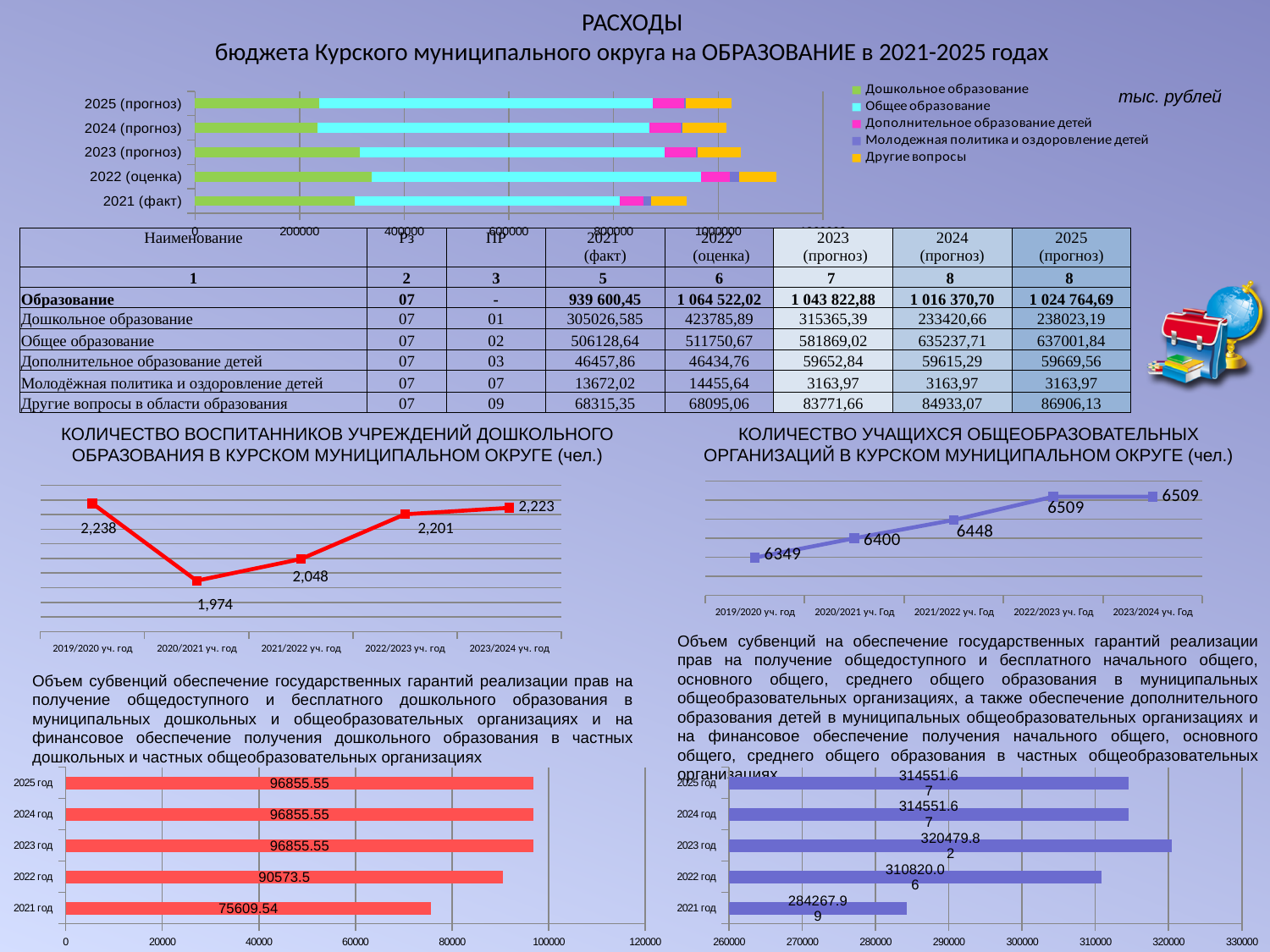
In the chart 'КОЛИЧЕСТВО ВОСПИТАННИКОВ УЧРЕЖДЕНИЙ ДОШКОЛЬНОГО ОБРАЗОВАНИЯ', what is the difference between the values for 2019/2020 and 2020/2021? 264 In the chart 'КОЛИЧЕСТВО УЧАЩИХСЯ ОБЩЕОБРАЗОВАТЕЛЬНЫХ ОРГАНИЗАЦИЙ', what is the value for 2019/2020 уч. год? 6349 In the bottom-left bar chart (subsidies for preschool education), what is the value for 2021 год? 75609.54 In the chart 'КОЛИЧЕСТВО УЧАЩИХСЯ ОБЩЕОБРАЗОВАТЕЛЬНЫХ ОРГАНИЗАЦИЙ', do the values rise or fall from 2019/2020 to 2023/2024? rise In the top stacked bar chart of education expenses, how many series does the legend list? 5 In the chart 'КОЛИЧЕСТВО ВОСПИТАННИКОВ УЧРЕЖДЕНИЙ ДОШКОЛЬНОГО ОБРАЗОВАНИЯ', which school year has the highest value? 2019/2020 уч. год In the bottom-right bar chart (subsidies for general education), is the value for 2021 год greater or less than 290000? less In the top stacked bar chart, how many years (categories) are plotted? 5 In the bottom-right bar chart (subsidies for general education), which year has the highest value? 2023 год What kind of chart is the top chart showing education expenses for 2021-2025? bar chart In the chart 'КОЛИЧЕСТВО ВОСПИТАННИКОВ УЧРЕЖДЕНИЙ ДОШКОЛЬНОГО ОБРАЗОВАНИЯ', what is the value for 2020/2021 уч. год? 1,974 In the bottom-left bar chart (subsidies for preschool education), what is the difference between the values for 2023 год and 2022 год? 6282.05